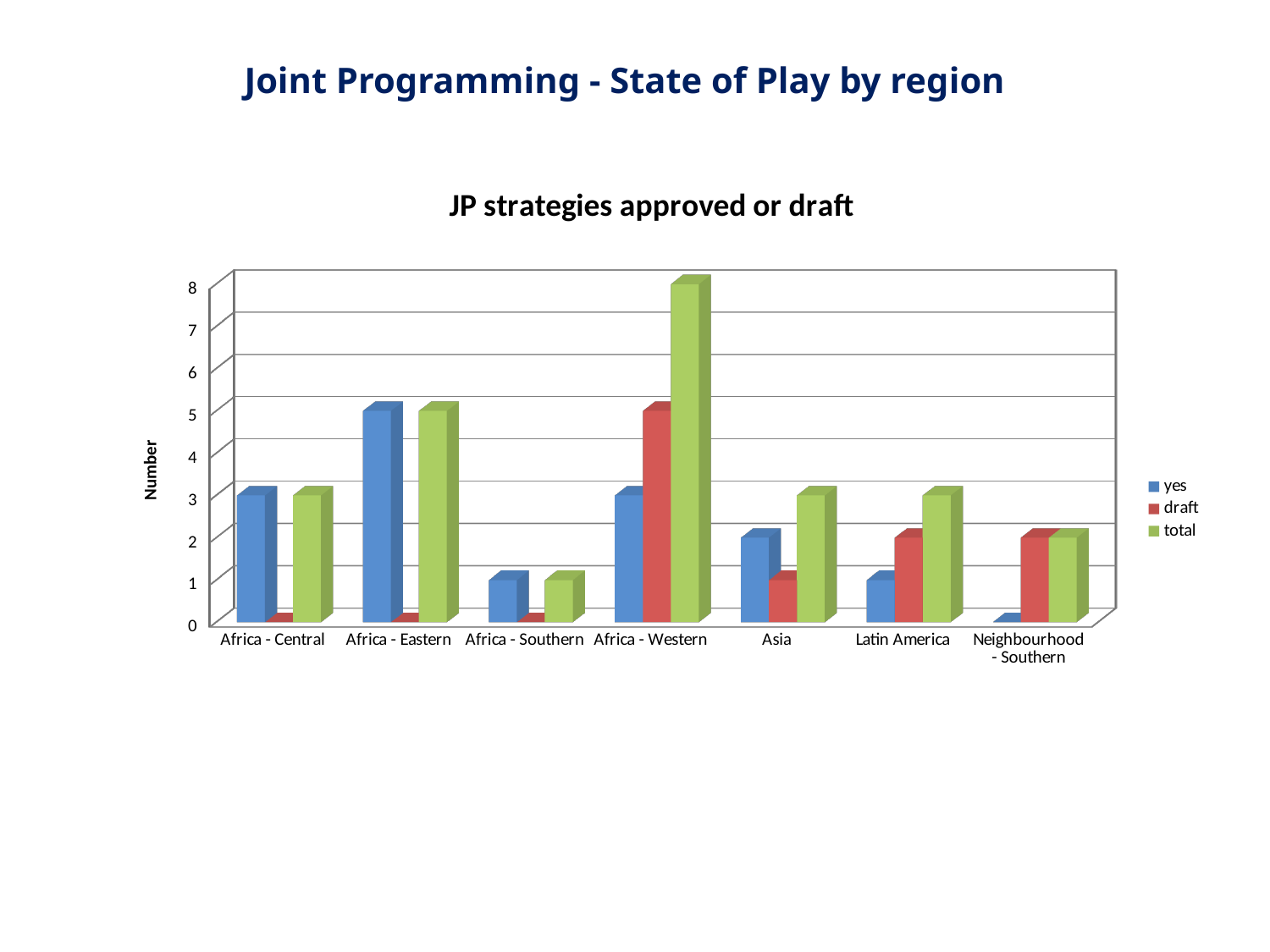
What is the label on the vertical axis? Number How many series does the legend list? 3 Which region has the highest total value? Africa - Western Is the draft value for Africa - Western greater or less than 4? greater Which is larger for Latin America, the yes value or the draft value? draft How many regions are shown on the x axis? 7 What kind of chart is shown on the slide? bar chart Is the yes value for Asia greater or less than 4? less What is the title of the chart? JP strategies approved or draft What is the total value for Africa - Western? 8 What is the yes value for Africa - Eastern? 5 Which region has the lowest total value? Africa - Southern